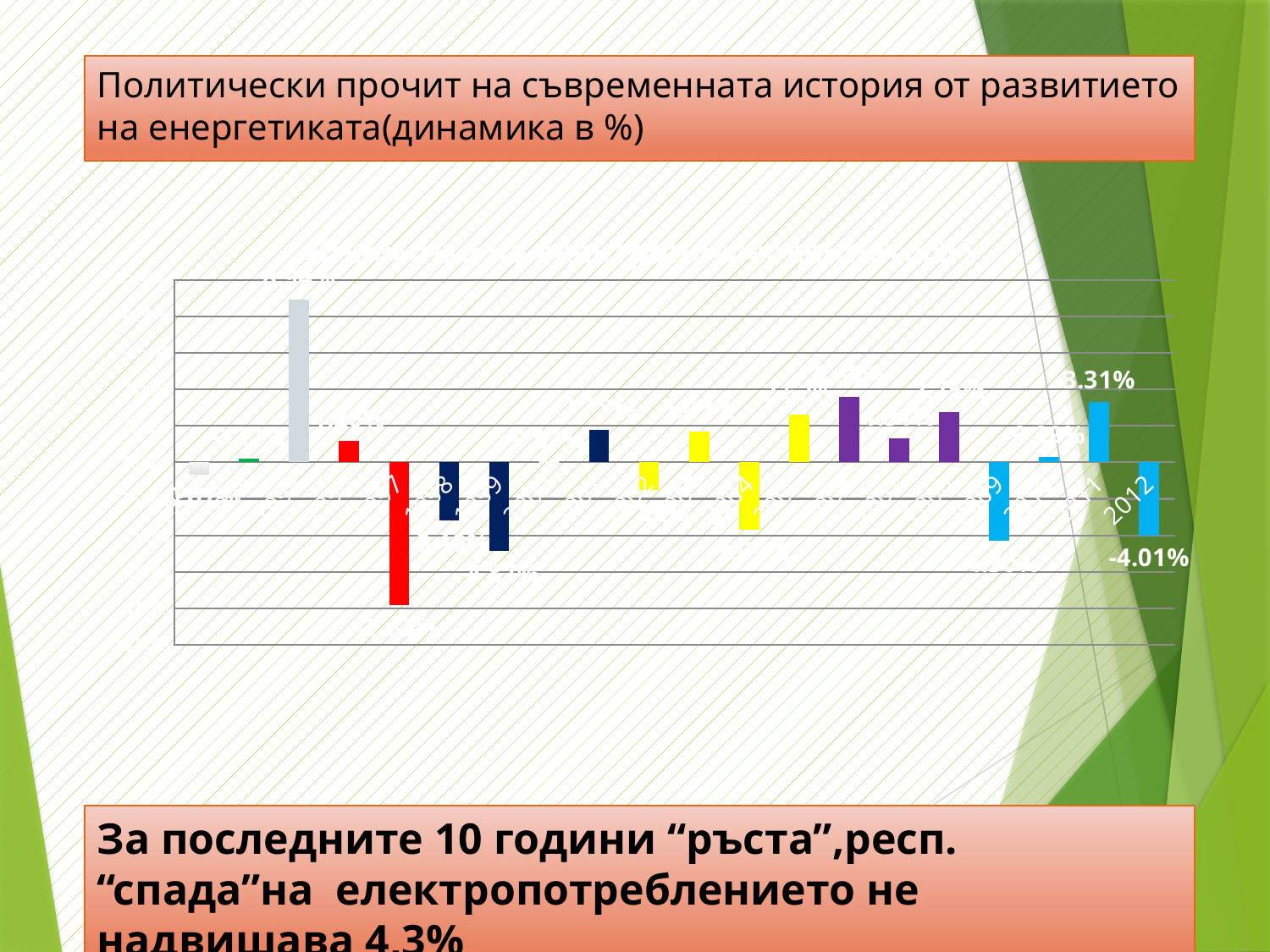
Which year has the value -4.01%? 2012 What colour is the bar for 2012? light blue What kind of chart is shown on the slide? bar chart What is the value for 2012? -4.01% Is the value for 2012 greater or less than 0? less Does the chart include bars with negative values? yes